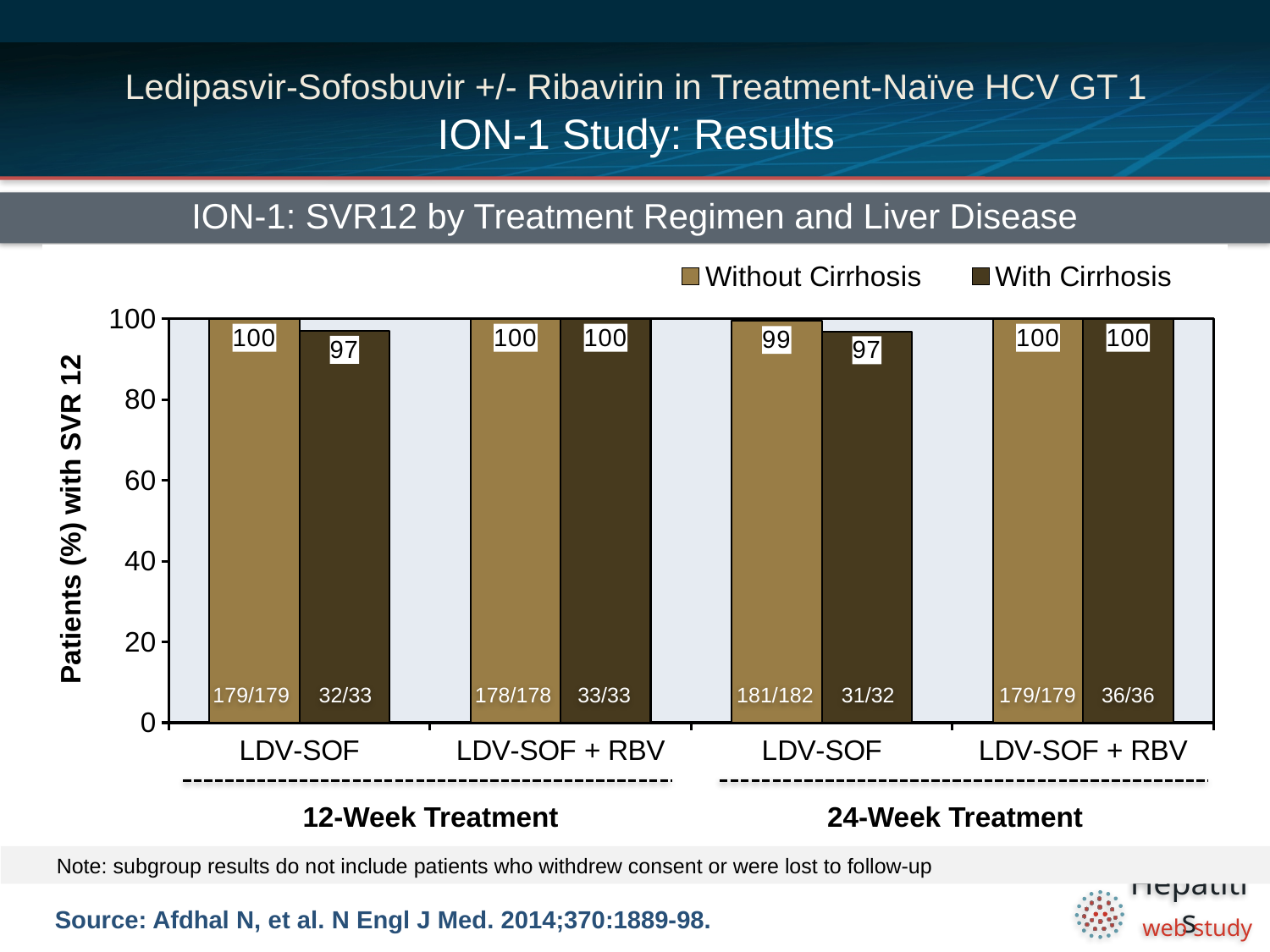
In the 24-week LDV-SOF group, which has the higher SVR12 rate: patients without cirrhosis or with cirrhosis? Without Cirrhosis Which treatment group has the lowest SVR12 rate for patients without cirrhosis? LDV-SOF, 24-Week Treatment What is the SVR12 rate for patients without cirrhosis receiving LDV-SOF for 24 weeks? 99 What is the difference between the SVR12 rates for patients without cirrhosis and with cirrhosis in the 12-week LDV-SOF group? 3 What is the label of the y axis? Patients (%) with SVR 12 What fraction of patients with cirrhosis achieved SVR12 with LDV-SOF + RBV for 24 weeks? 36/36 How many series does the legend list? 2 What type of chart is shown on the slide? Bar chart What fraction of patients without cirrhosis achieved SVR12 with LDV-SOF + RBV for 12 weeks? 178/178 What is the title of the chart? ION-1: SVR12 by Treatment Regimen and Liver Disease What is the SVR12 rate for patients with cirrhosis receiving LDV-SOF for 12 weeks? 97 How many treatment regimen categories are shown on the x axis? 4